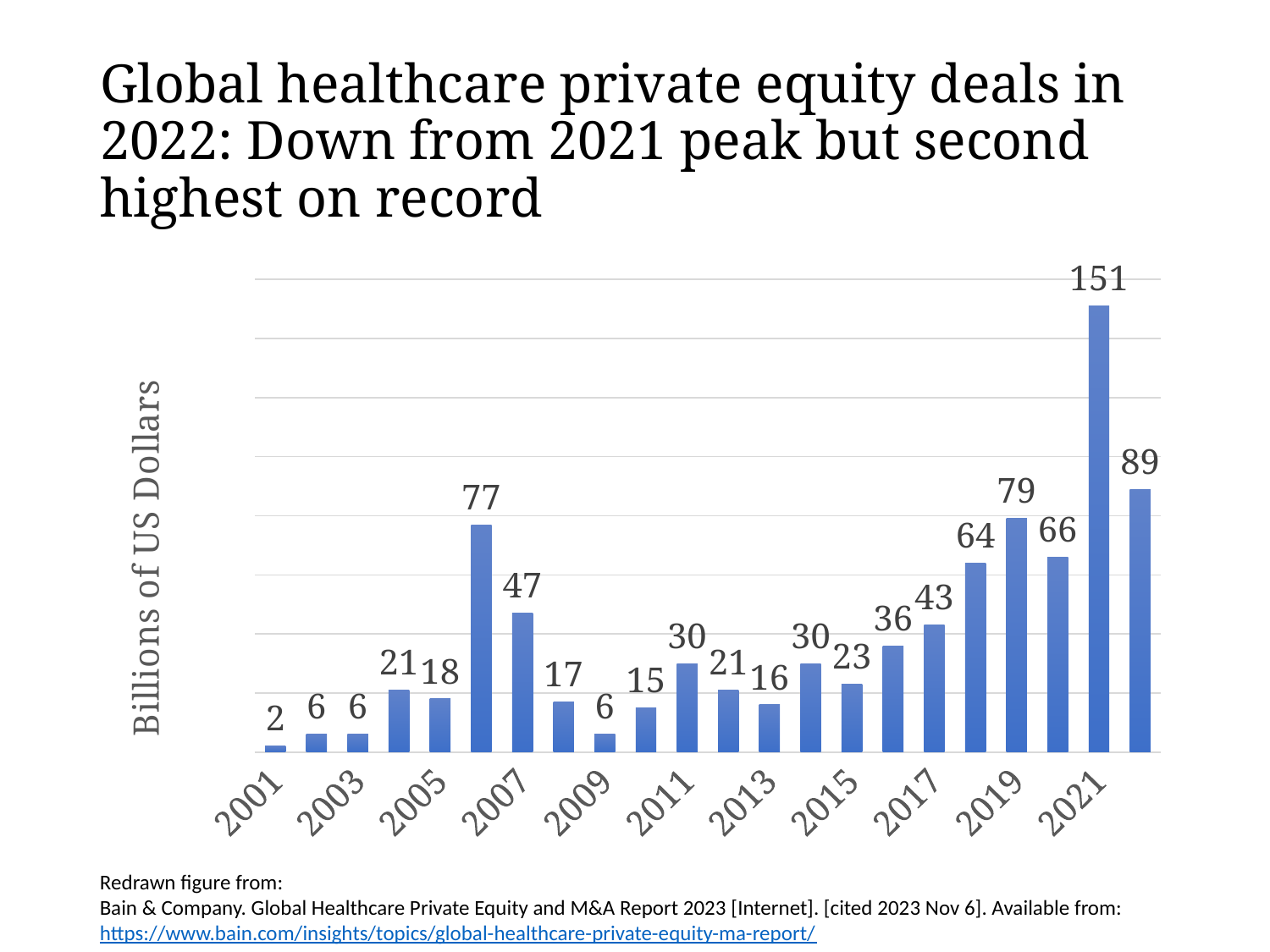
Which year has the highest value? 2021 How many bars are plotted in the chart? 22 Which year has the lowest value? 2001 What is the label on the vertical axis? Billions of US Dollars What is the value for 2021? 151 Which is larger, the value for 2005 or the value for 2011? 2011 What is the value for 2007? 47 What is the value for 2001? 2 What is the difference between the values for 2017 and 2015? 20 What is the difference between the values for 2021 and 2019? 72 What is the value for 2019? 79 What type of chart is shown on the slide? bar chart